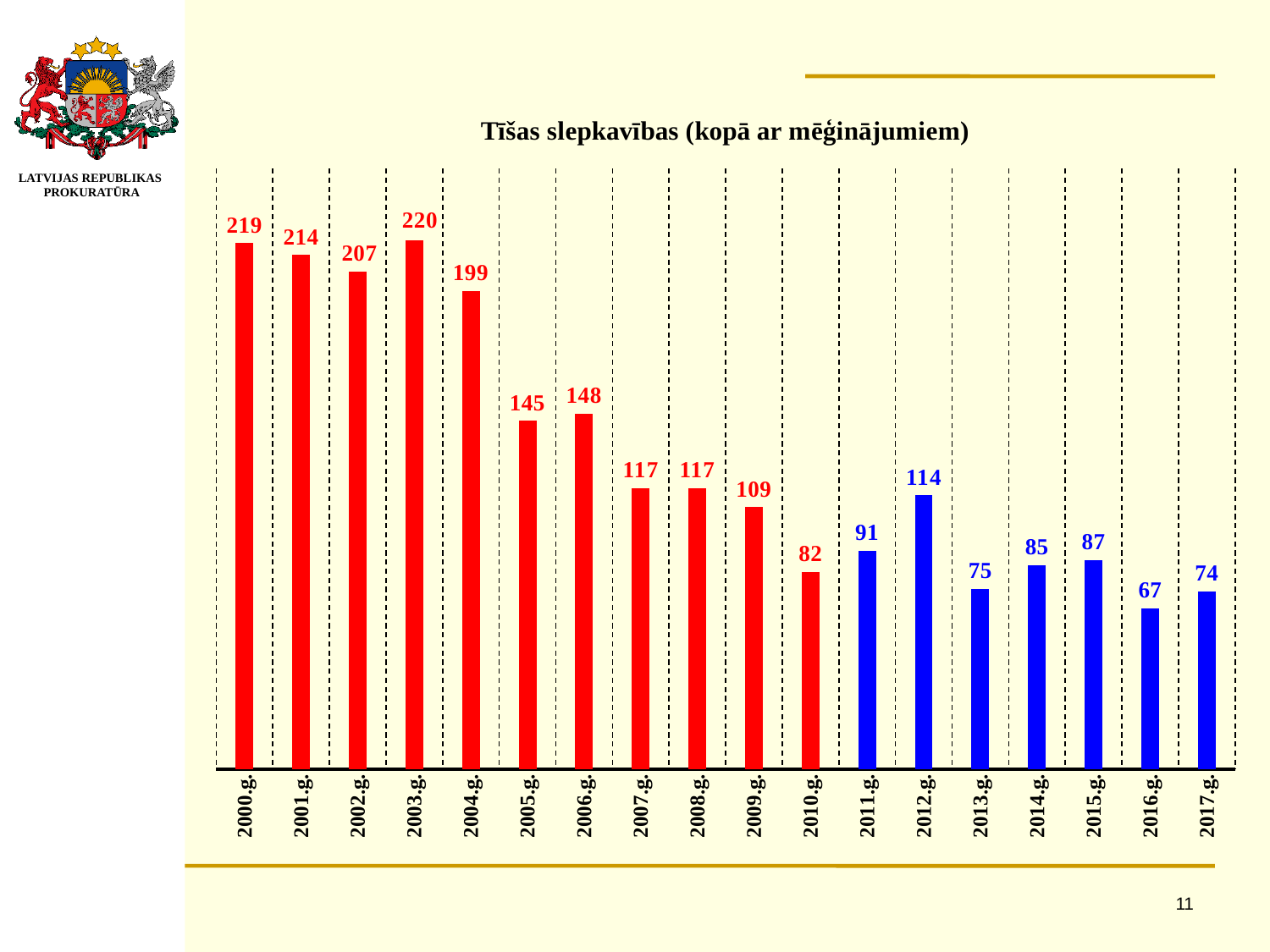
What is the value for 2016.g.? 67 What kind of chart is shown on the slide? bar chart Which is larger, the value for 2012.g. or the value for 2009.g.? 2009.g. What is the value for 2010.g.? 82 What is the value for 2003.g.? 220 How many years are shown on the x axis? 18 Which year has the lowest value? 2016.g. What colour are the bars for 2011.g. through 2017.g.? blue What is the title of the chart? Tīšas slepkavības (kopā ar mēģinājumiem) What is the difference between the values for 2000.g. and 2017.g.? 145 Which year has the highest value? 2003.g. Do the values generally rise or fall from 2000.g. to 2017.g.? fall